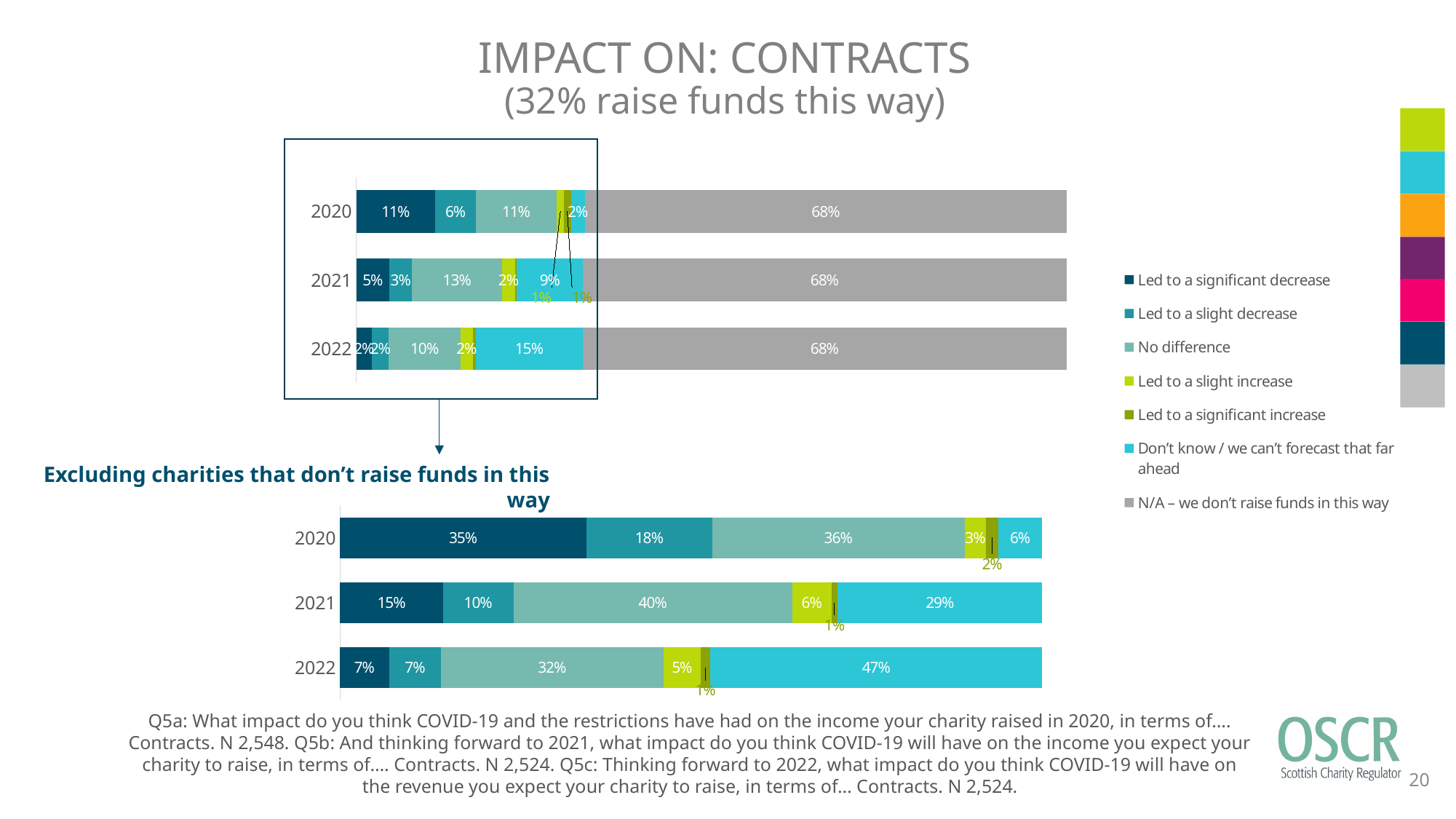
In the top chart, what is the 'Don't know / we can't forecast that far ahead' value for 2022? 15% In the bottom chart (Excluding charities that don't raise funds in this way), does the 'Led to a significant decrease' value rise or fall from 2020 to 2022? Fall In the bottom chart (Excluding charities that don't raise funds in this way), what is the 'Led to a slight increase' value for 2021? 6% In the top chart, what percentage for 2021 is 'N/A – we don't raise funds in this way'? 68% How many entries does the legend list? 7 In the bottom chart (Excluding charities that don't raise funds in this way), what percentage of respondents in 2020 said COVID-19 led to a significant decrease? 35% In the bottom chart (Excluding charities that don't raise funds in this way), how many percentage points higher is the 'Don't know' value for 2022 than for 2021? 18 percentage points What kind of chart is used on this slide? Stacked bar chart In the bottom chart (Excluding charities that don't raise funds in this way), what is the 'No difference' value for 2021? 40% In the bottom chart (Excluding charities that don't raise funds in this way), which year has the highest 'Don't know / we can't forecast that far ahead' value? 2022 In the bottom chart (Excluding charities that don't raise funds in this way), which year has the larger 'Led to a significant decrease' value, 2020 or 2022? 2020 In the bottom chart (Excluding charities that don't raise funds in this way), what is the 'Don't know / we can't forecast that far ahead' value for 2022? 47%